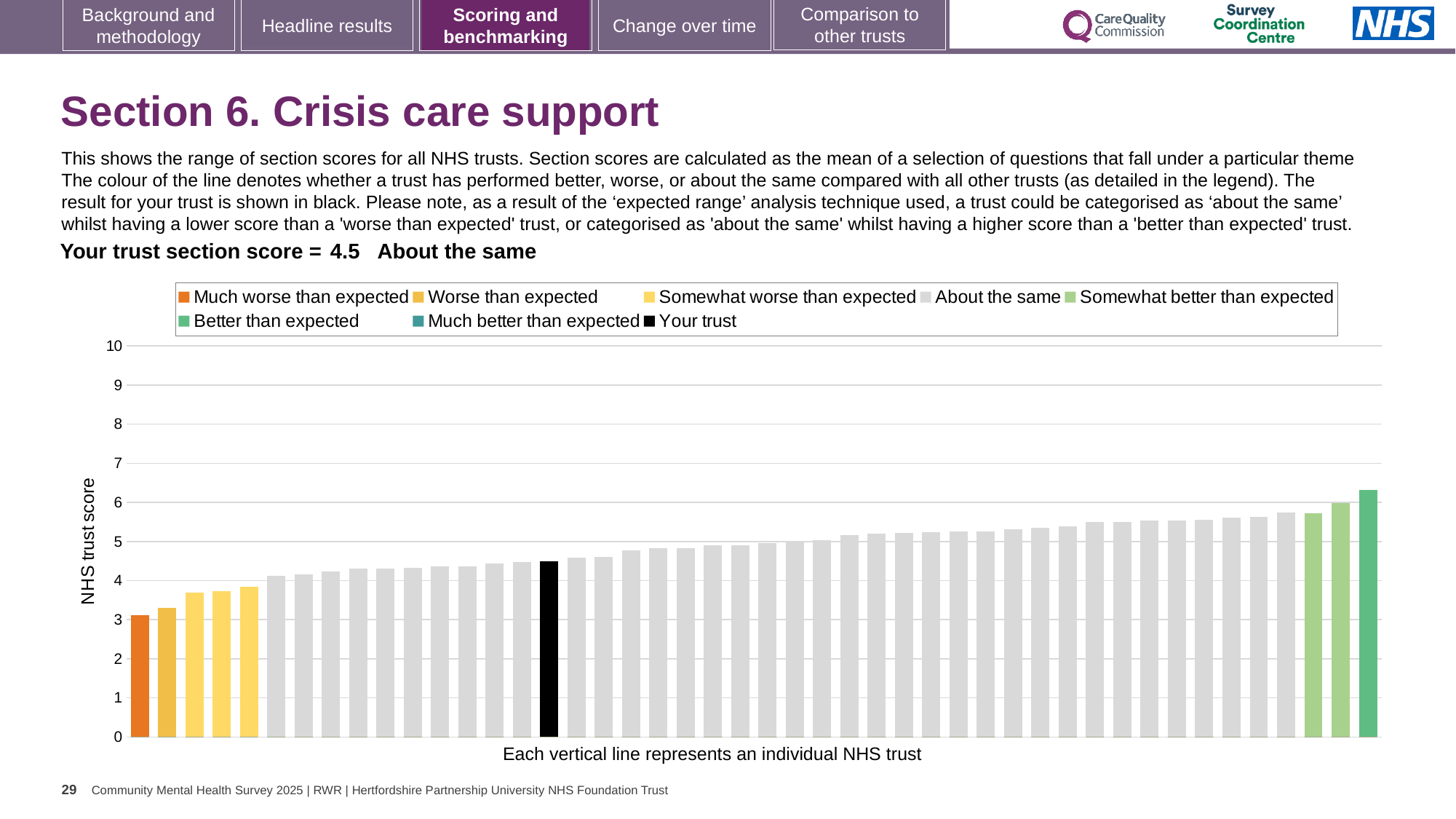
What is the label on the vertical axis of the chart? NHS trust score What kind of chart is shown on the slide? bar chart What category is your trust's section score placed in? About the same Do the bar values rise or fall from left to right along the x axis? rise Which legend category does the shortest bar belong to? Much worse than expected Is the value of the tallest bar greater or less than 6? greater Which legend category does the tallest bar belong to? Better than expected What is the section score for your trust shown on the slide? 4.5 How many entries does the chart legend list? 8 Is the value of the shortest bar greater or less than 4? less How many bars are coloured as 'Somewhat better than expected'? 2 Is the value for your trust (the black bar) greater or less than 5? less